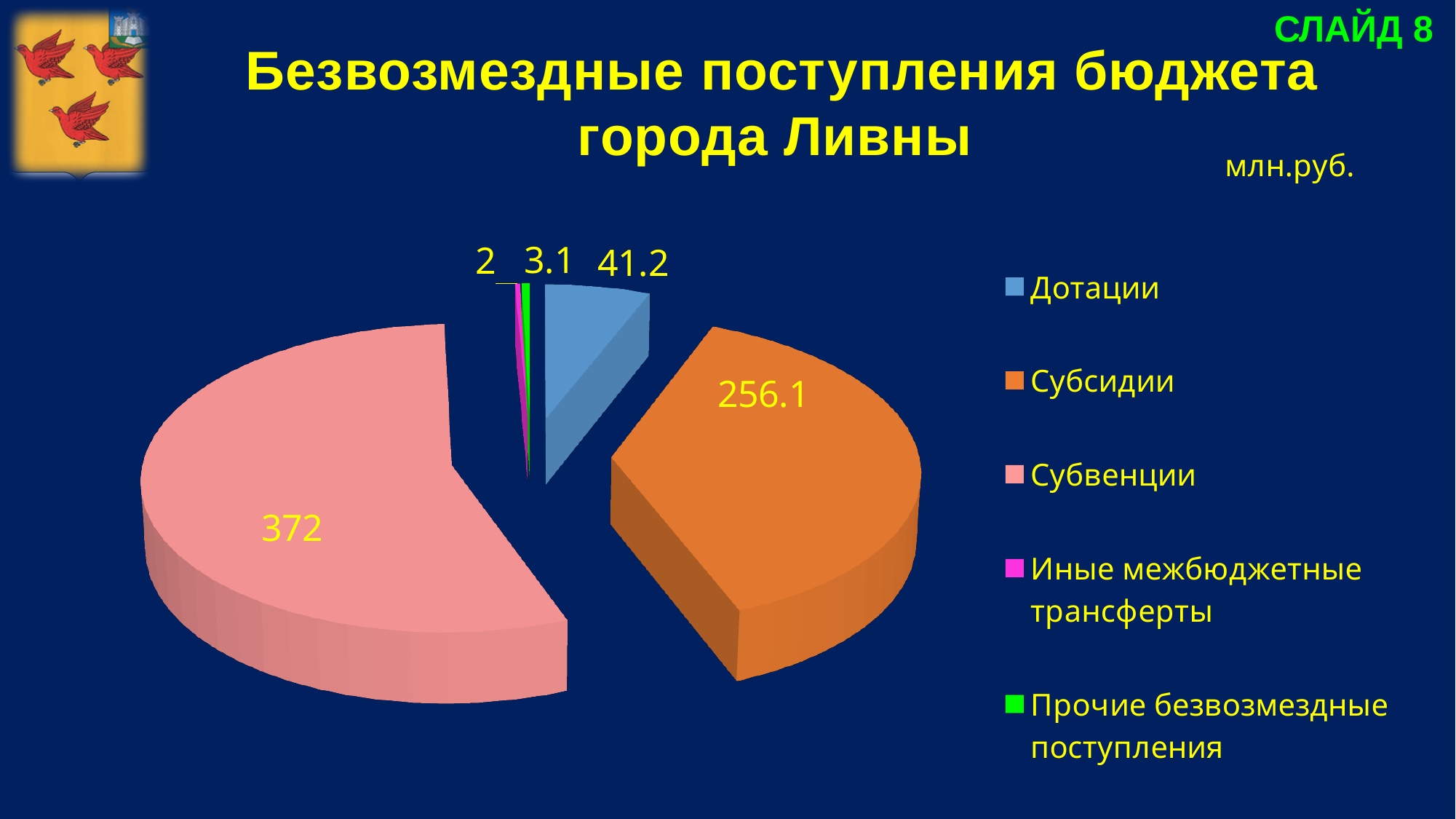
Which category has the largest slice of the pie? Субвенции What is the difference between the values for Субвенции and Субсидии? 115.9 How many categories does the legend list? 5 What kind of chart is shown on the slide? pie chart What is the value for Дотации? 41.2 What unit is stated for the values on the chart? млн.руб. What is the total of all the values shown on the pie chart? 674.4 Which is larger, the value for Субсидии or the value for Дотации? Субсидии What is the difference between the values for Субсидии and Дотации? 214.9 What is the value for Субсидии? 256.1 What is the value for Субвенции? 372 What colour is the slice for Субсидии? orange